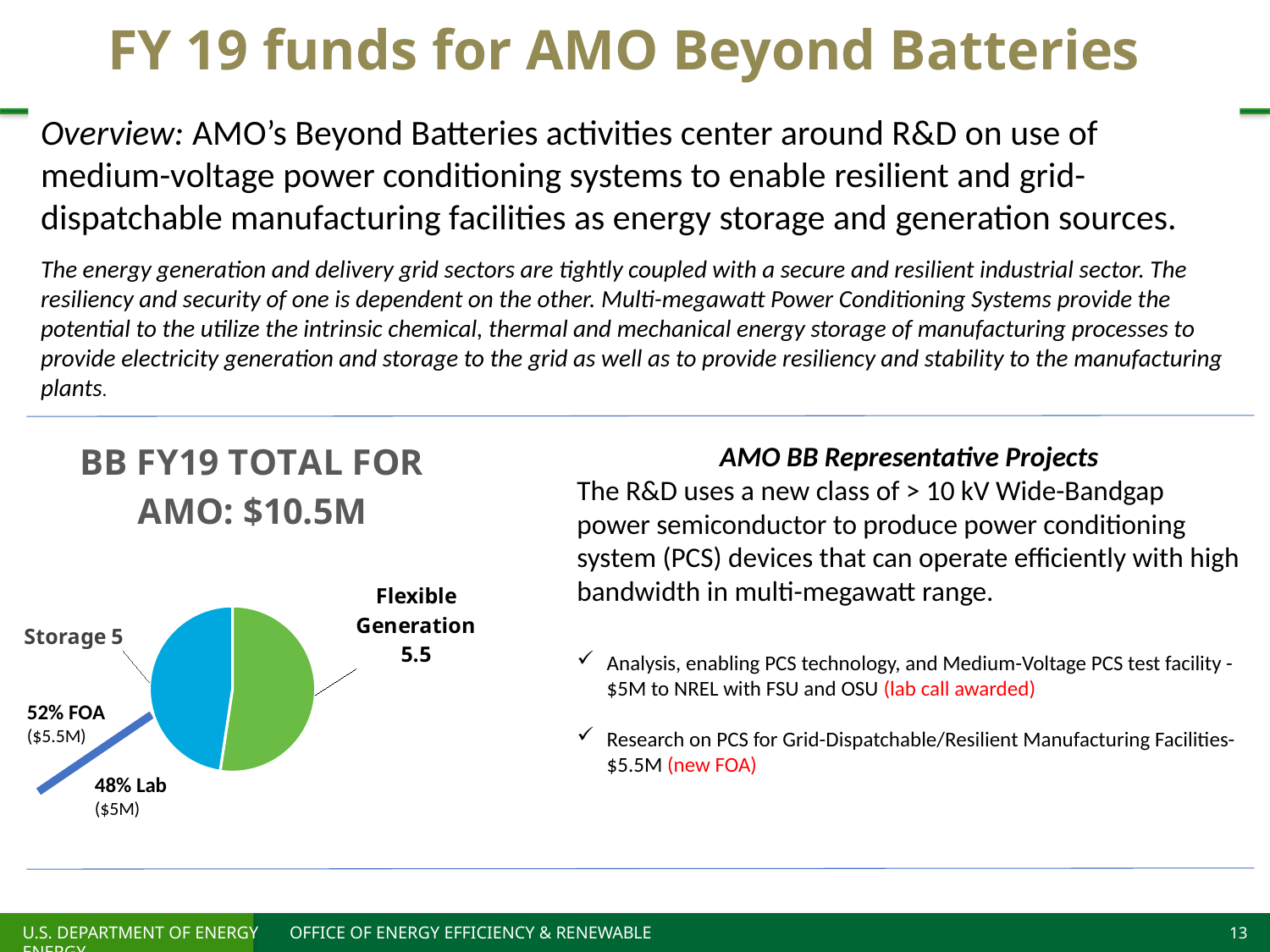
Which is larger in the pie chart, Flexible Generation or Storage? Flexible Generation What is the value of the Flexible Generation slice in the pie chart? 5.5 Which slice of the pie chart is the largest? Flexible Generation What is the total of the two slices in the pie chart? 10.5 What is the title of the pie chart? BB FY19 TOTAL FOR AMO: $10.5M What kind of chart is shown on the slide? pie chart How many slices does the pie chart have? 2 What colour is the Flexible Generation slice in the pie chart? green What is the difference between the Flexible Generation value and the Storage value in the pie chart? 0.5 Which slice of the pie chart is the smallest? Storage What is the value of the Storage slice in the pie chart? 5